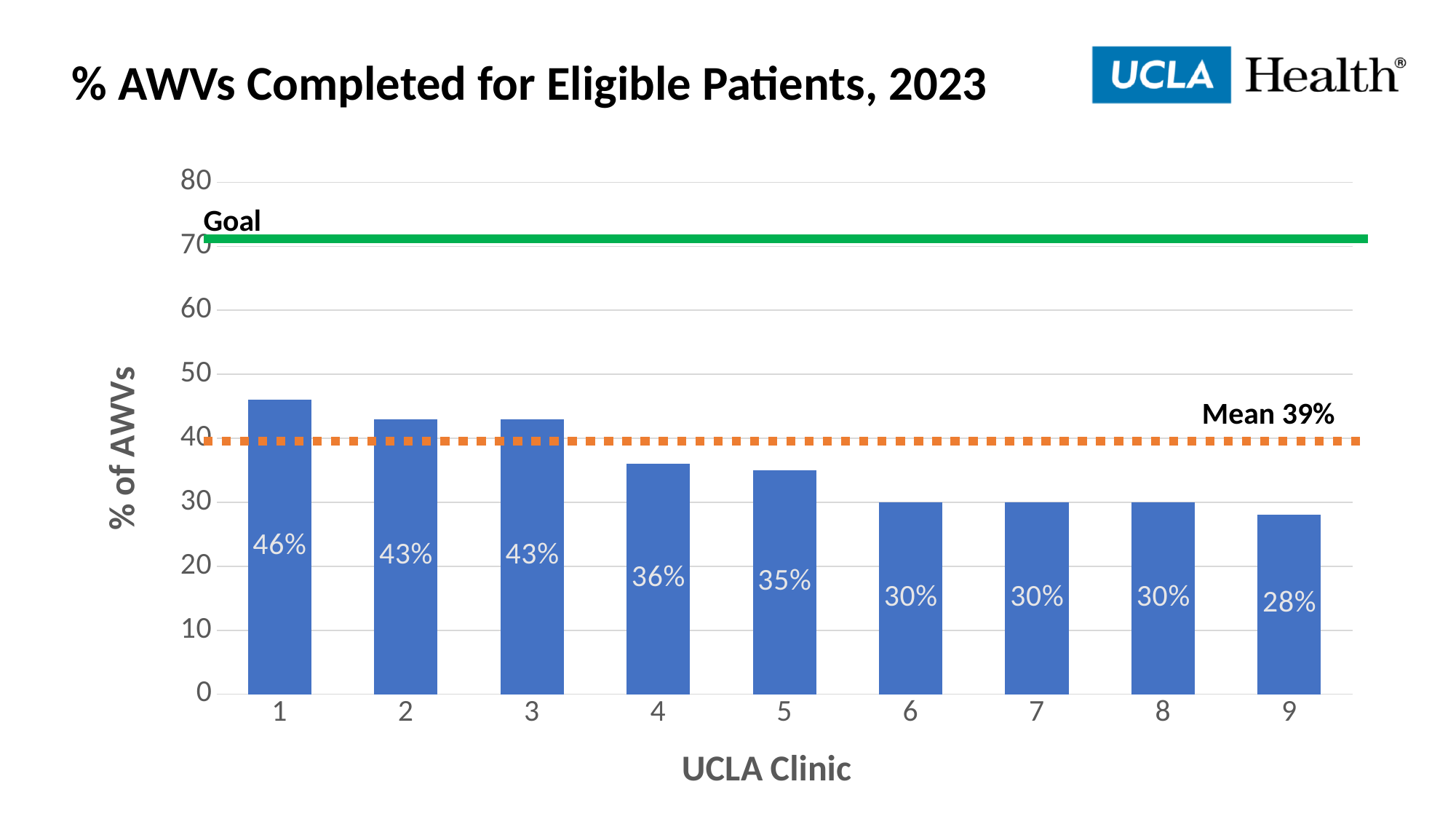
What percentage of AWVs were completed for eligible patients at UCLA Clinic 1? 46% Which UCLA Clinic has the lowest % of AWVs completed? 9 What mean value is labelled on the dotted line in the chart? 39% What is the value shown for UCLA Clinic 5? 35% What kind of chart is shown on the slide? Bar chart How many UCLA Clinics are shown on the x axis? 9 Which UCLA Clinic has the highest % of AWVs completed? 1 What is the difference between the values for Clinic 4 and Clinic 5? 1% What is the difference between the values for Clinic 1 and Clinic 9? 18% Do the values rise or fall from Clinic 1 to Clinic 9? Fall Which has a higher % of AWVs completed, Clinic 4 or Clinic 6? Clinic 4 What is the value shown for UCLA Clinic 9? 28%